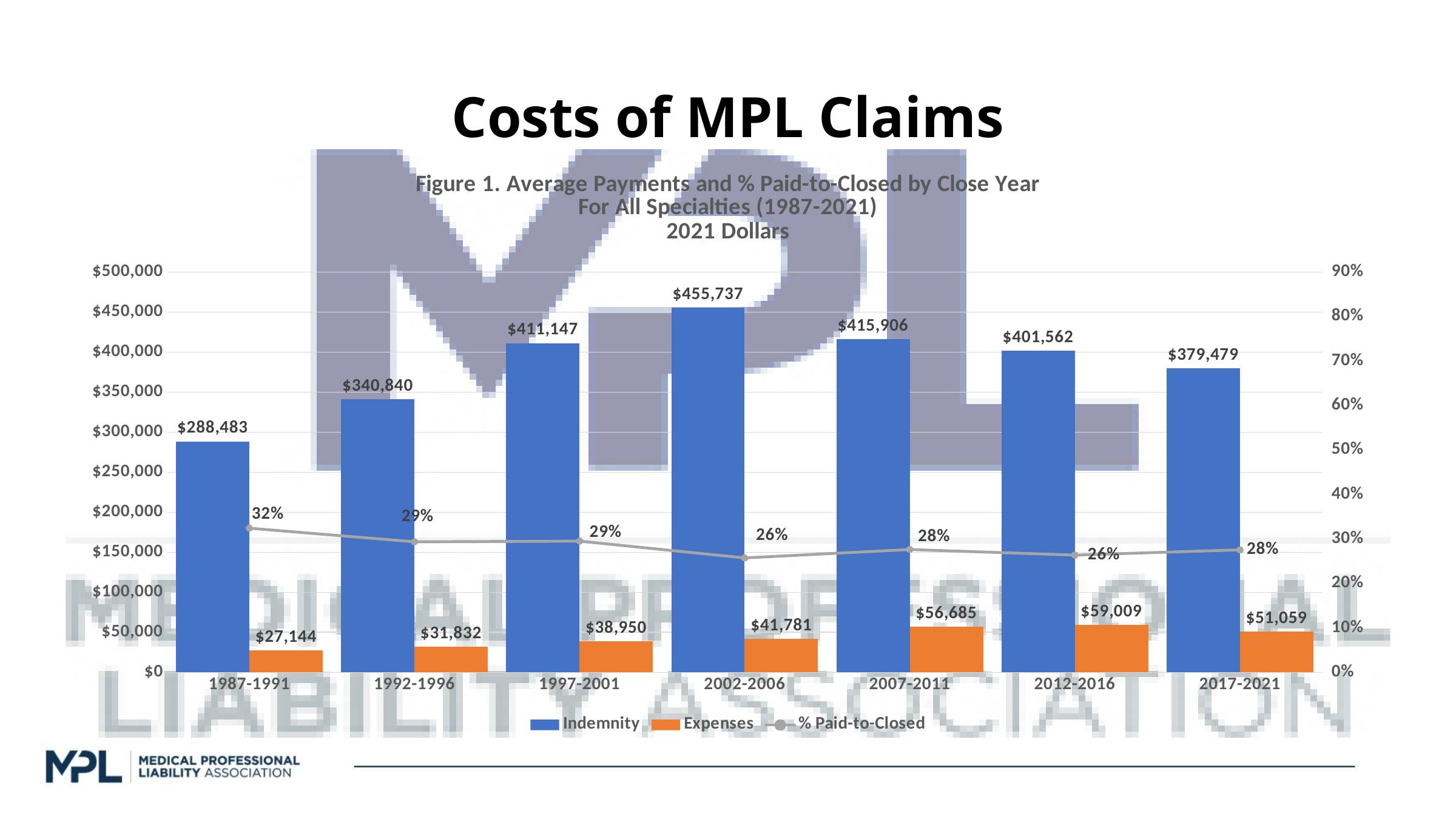
Which period has the lowest Expenses value? 1987-1991 How many periods are shown on the x axis? 7 Does the Expenses value rise or fall from 1987-1991 to 2012-2016? Rise What kind of chart is used to show Indemnity and Expenses? Bar chart What is the % Paid-to-Closed value for 1987-1991? 32% Which is larger, the Indemnity value for 2007-2011 or for 2012-2016? 2007-2011 What is the difference between the Indemnity values for 2002-2006 and 1987-1991? $167,254 What is the difference between the Expenses values for 2012-2016 and 1987-1991? $31,865 Which period has the highest Indemnity value? 2002-2006 How many series does the legend list? 3 What is the Expenses value for 2017-2021? $51,059 What is the Indemnity value for 2002-2006? $455,737